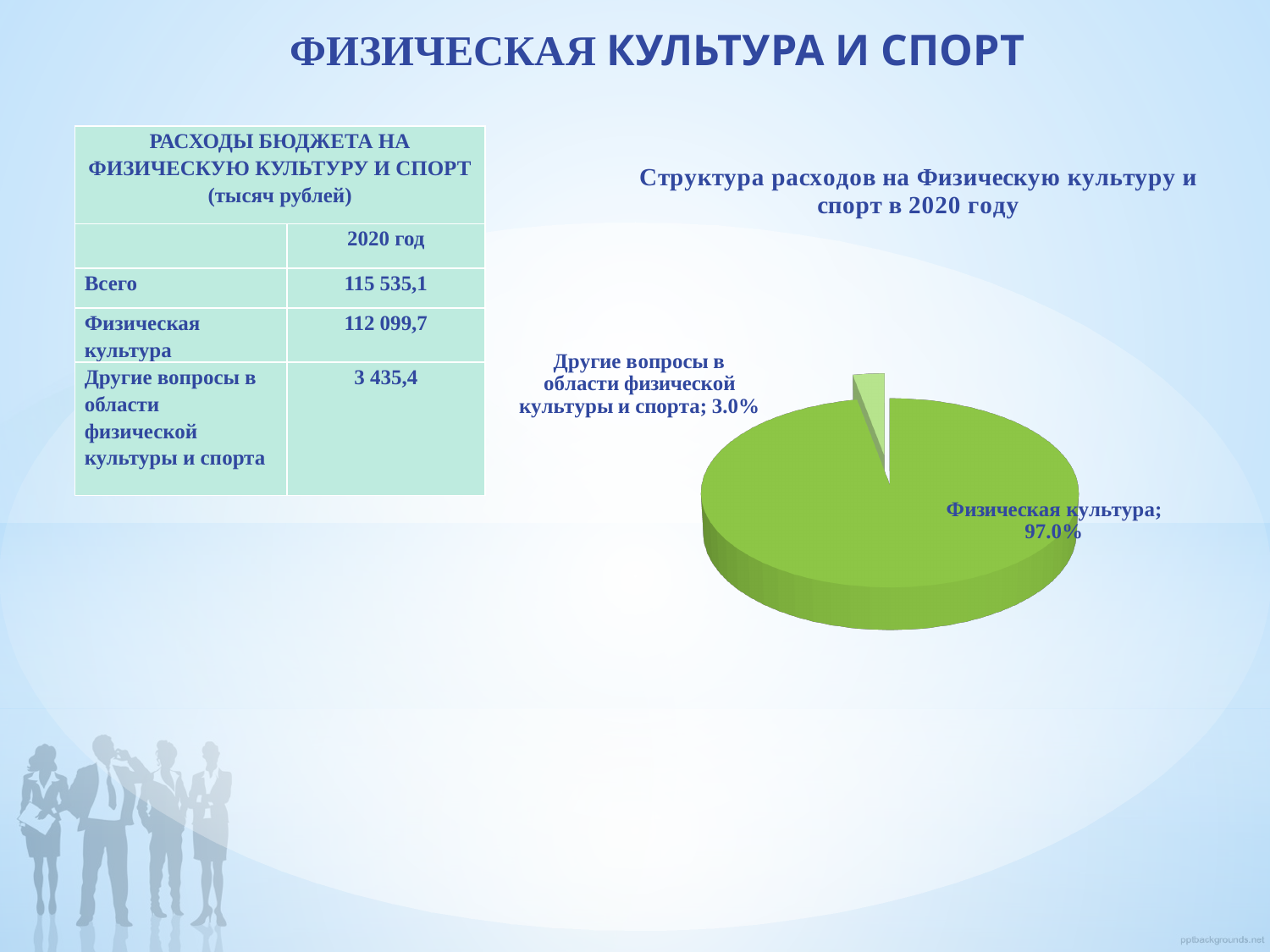
Which year does the pie chart's title refer to? 2020 What is the difference in percentage points between the "Физическая культура" slice and the "Другие вопросы в области физической культуры и спорта" slice? 94.0 percentage points What share of the pie does "Другие вопросы в области физической культуры и спорта" have? 3.0% Which is larger in the pie chart: "Физическая культура" or "Другие вопросы в области физической культуры и спорта"? Физическая культура Is the share for "Другие вопросы в области физической культуры и спорта" greater or less than 10%? less Is the share for "Физическая культура" greater or less than 50%? greater What share of the pie does "Физическая культура" have? 97.0% What is the title of the pie chart? Структура расходов на Физическую культуру и спорт в 2020 году Which slice of the pie chart is the largest? Физическая культура What kind of chart is shown on the slide? Pie chart Which slice of the pie chart is the smallest? Другие вопросы в области физической культуры и спорта How many slices does the pie chart have? 2